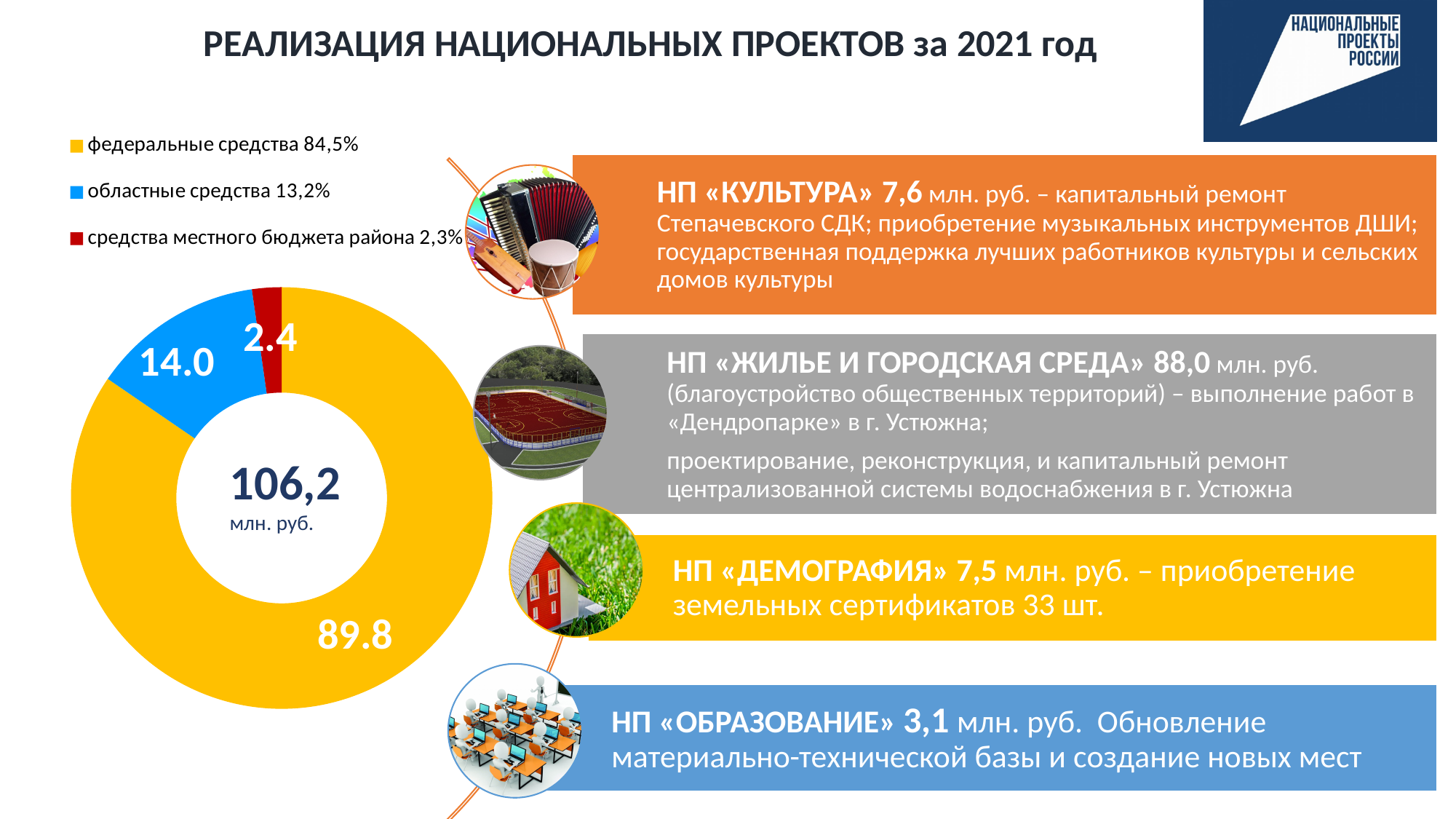
What share of the total do федеральные средства represent, according to the legend? 84,5% What total is printed in the centre of the doughnut chart? 106,2 млн. руб. What value is shown for областные средства on the doughnut chart? 14.0 What value is shown for средства местного бюджета района on the doughnut chart? 2.4 What kind of chart is shown on the slide? doughnut (pie) chart How many categories does the doughnut chart show? 3 What value is shown for федеральные средства on the doughnut chart? 89.8 Which category has the smallest slice of the doughnut chart? средства местного бюджета района Which category has the largest slice of the doughnut chart? федеральные средства Which is larger: областные средства or средства местного бюджета района? областные средства What is the difference between the values for областные средства and средства местного бюджета района? 11.6 What is the difference between the values for федеральные средства and областные средства? 75.8